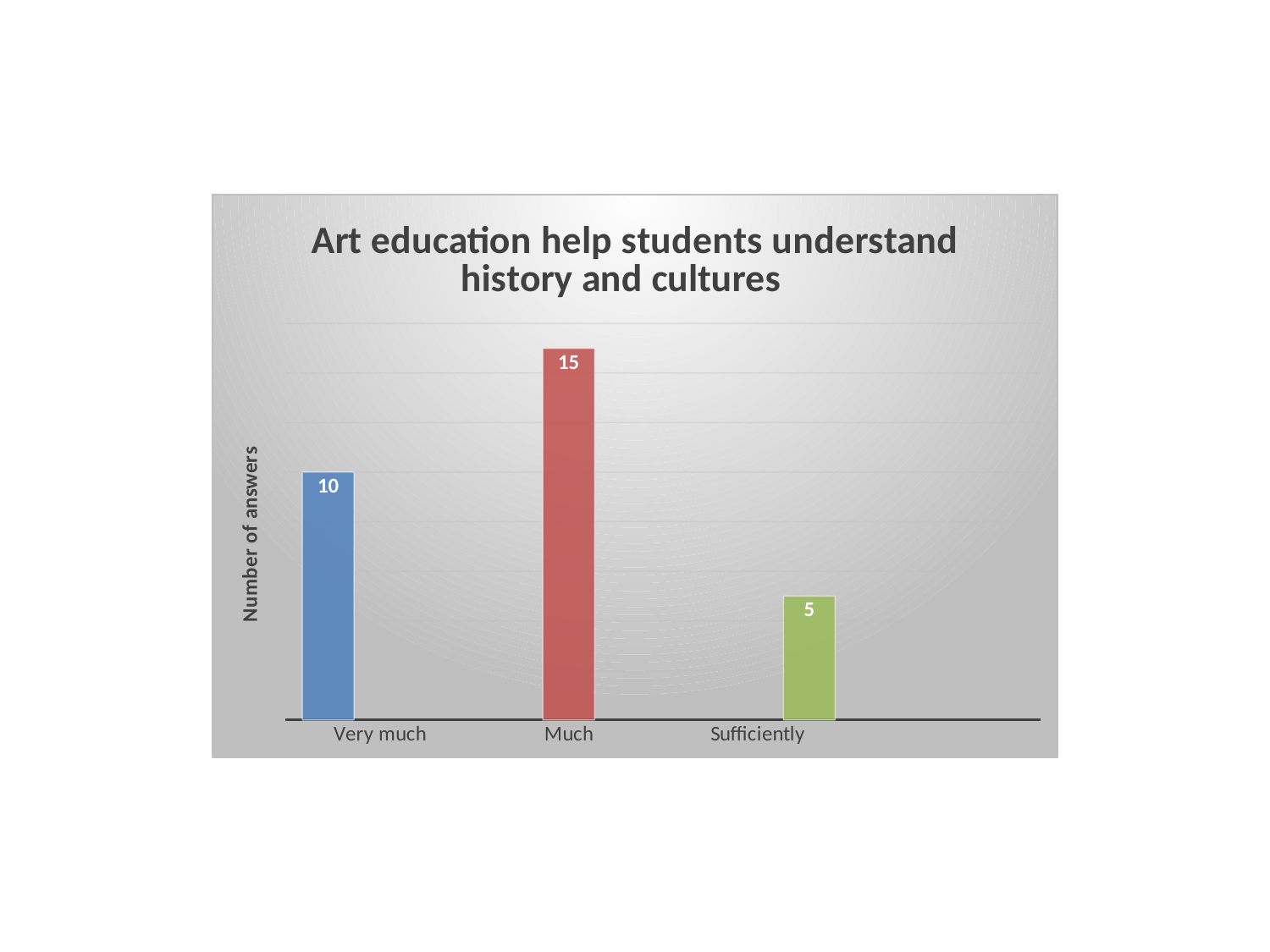
What is the title of the chart? Art education help students understand history and cultures What is the value for "Very much"? 10 What is the difference between the values for "Much" and "Very much"? 5 What is the value for "Much"? 15 What is the label of the vertical axis? Number of answers Which is larger, the value for "Very much" or the value for "Sufficiently"? Very much Which category has the lowest number of answers? Sufficiently What is the difference between the values for "Very much" and "Sufficiently"? 5 What kind of chart is shown on the slide? Bar chart How many categories are shown on the x axis? 3 What is the value for "Sufficiently"? 5 Which category has the highest number of answers? Much